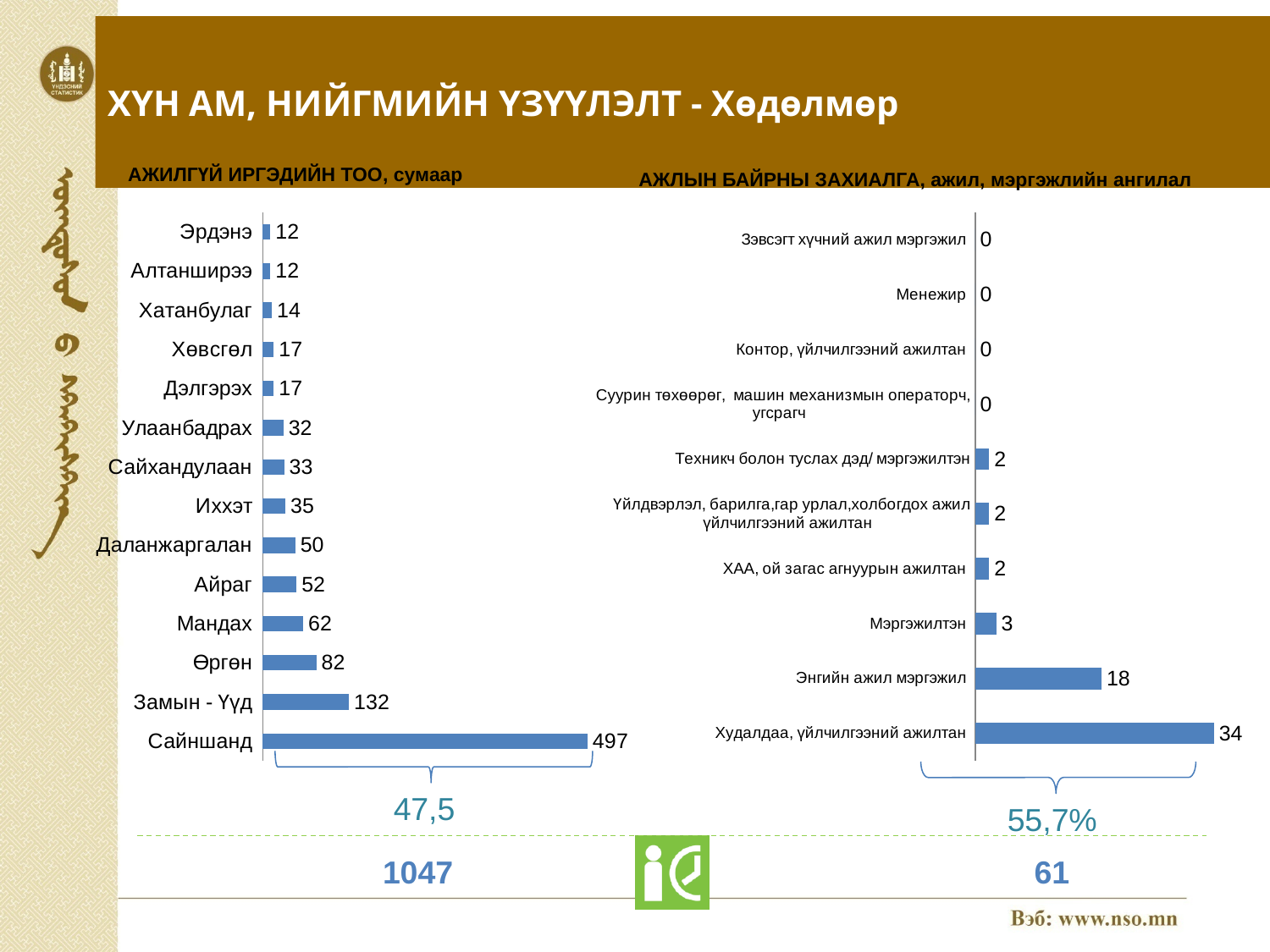
In the chart titled "АЖИЛГҮЙ ИРГЭДИЙН ТОО, сумаар", which category has the highest value? Сайншанд In the chart titled "АЖЛЫН БАЙРНЫ ЗАХИАЛГА, ажил, мэргэжлийн ангилал", what is the difference between the values for Худалдаа, үйлчилгээний ажилтан and Энгийн ажил мэргэжил? 16 In the chart titled "АЖИЛГҮЙ ИРГЭДИЙН ТОО, сумаар", what is the value for Замын - Үүд? 132 In the chart titled "АЖИЛГҮЙ ИРГЭДИЙН ТОО, сумаар", how many categories are plotted? 14 In the chart titled "АЖИЛГҮЙ ИРГЭДИЙН ТОО, сумаар", what is the value for Сайншанд? 497 What kind of chart is the chart titled "АЖИЛГҮЙ ИРГЭДИЙН ТОО, сумаар"? Bar chart In the chart titled "АЖЛЫН БАЙРНЫ ЗАХИАЛГА, ажил, мэргэжлийн ангилал", how many categories are plotted? 10 In the chart titled "АЖЛЫН БАЙРНЫ ЗАХИАЛГА, ажил, мэргэжлийн ангилал", what is the value for Мэргэжилтэн? 3 In the chart titled "АЖЛЫН БАЙРНЫ ЗАХИАЛГА, ажил, мэргэжлийн ангилал", what is the value for Энгийн ажил мэргэжил? 18 In the chart titled "АЖИЛГҮЙ ИРГЭДИЙН ТОО, сумаар", what is the difference between the values for Өргөн and Мандах? 20 In the chart titled "АЖЛЫН БАЙРНЫ ЗАХИАЛГА, ажил, мэргэжлийн ангилал", what is the value for Худалдаа, үйлчилгээний ажилтан? 34 In the chart titled "АЖИЛГҮЙ ИРГЭДИЙН ТОО, сумаар", which is larger, the value for Айраг or the value for Иххэт? Айраг